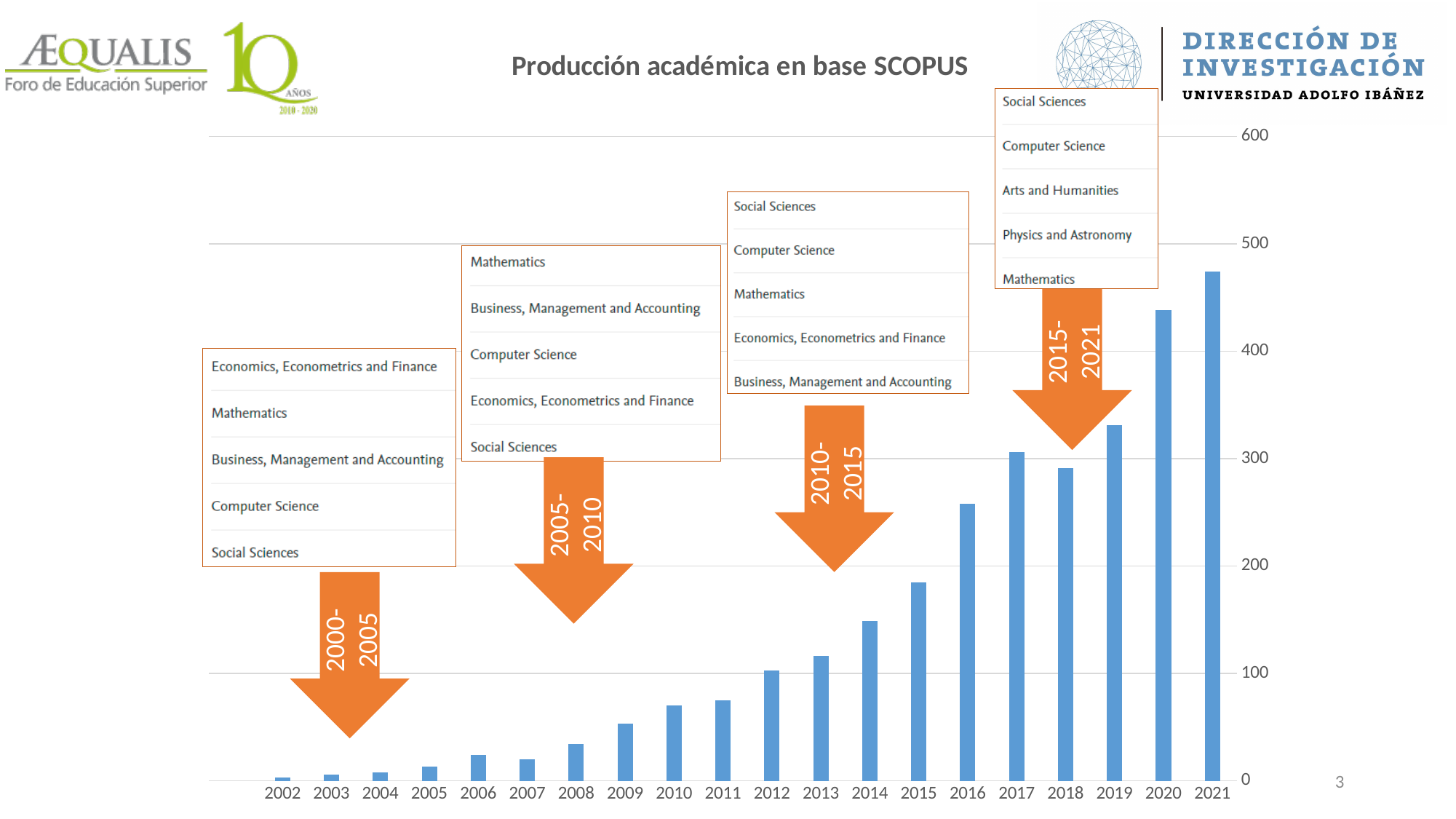
How many years are shown on the x axis of the chart? 20 Is the value for 2019 greater or less than 300? greater What kind of chart is shown on the slide? bar chart Which year has the highest bar in the chart? 2021 What is the title of the chart on the slide? Producción académica en base SCOPUS Do the values generally rise or fall from 2002 to 2021? rise Is the value for 2015 greater or less than 200? less Which year has the lowest bar in the chart? 2002 Is the value for 2018 greater or less than 300? less Which year has the larger value, 2017 or 2018? 2017